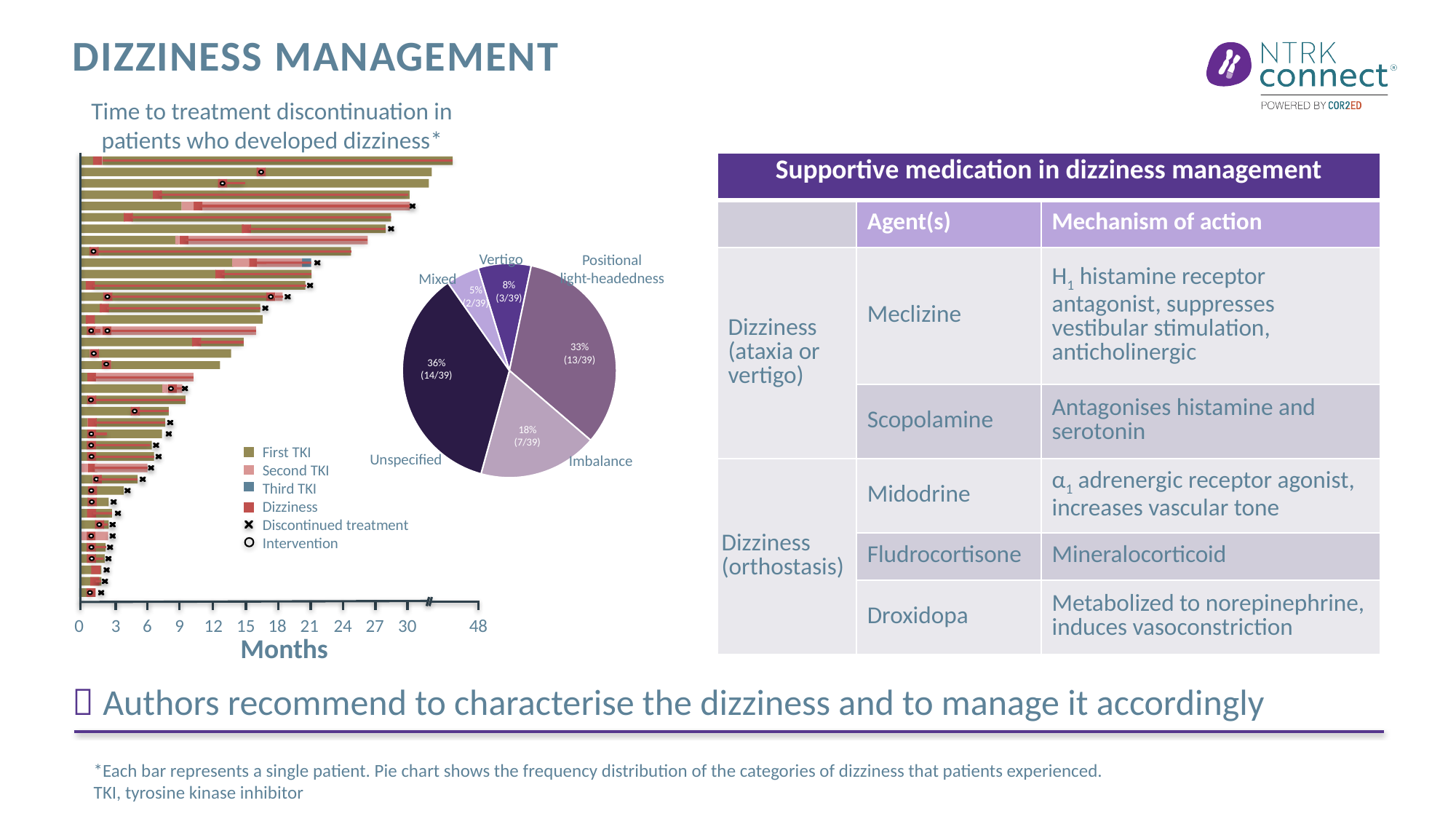
How many entries does the legend of the 'Time to treatment discontinuation' bar chart list? 6 How many slices does the pie chart have? 5 In the pie chart, what share of patients had Unspecified dizziness? 36% (14/39) What kind of chart is the chart on the right showing the categories of dizziness? Pie chart In the pie chart, what is the value shown for Vertigo? 8% (3/39) In the pie chart, which category of dizziness has the smallest share? Mixed In the pie chart, which has the larger share, Imbalance or Vertigo? Imbalance In the pie chart, which category of dizziness has the largest share? Unspecified In the 'Time to treatment discontinuation' bar chart, is the longest bar greater or less than 30 months? greater In the pie chart, what share of patients had Positional light-headedness? 33% (13/39) What kind of chart is the 'Time to treatment discontinuation in patients who developed dizziness' chart? Bar chart In the pie chart, how many percentage points larger is the Unspecified share than the Positional light-headedness share? 3%